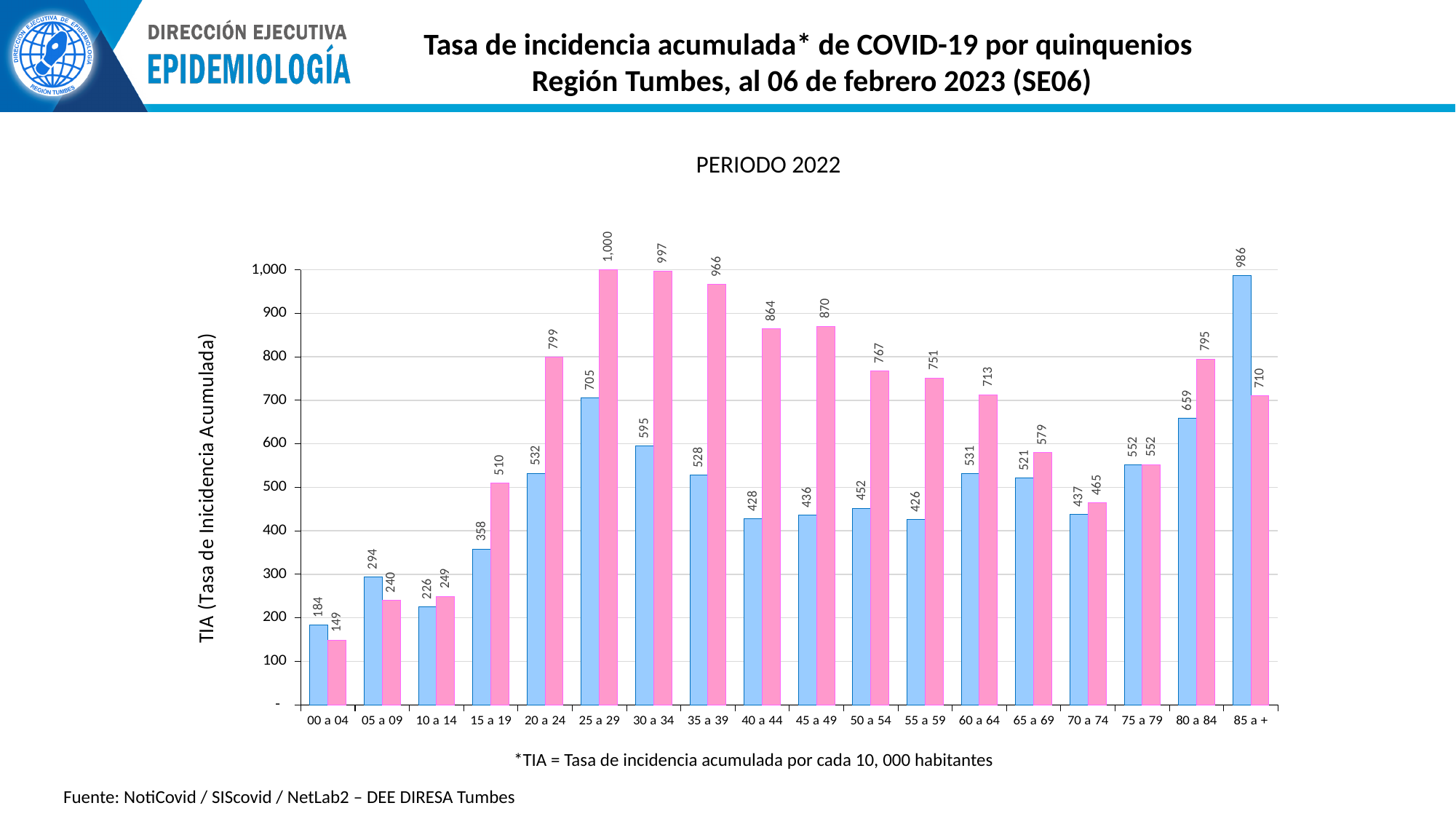
What is the subtitle shown above the chart? PERIODO 2022 What is the value of both bars for the 75 a 79 age group? 552 What type of chart is shown on the slide? bar chart What is the difference between the pink bar and the blue bar for the 20 a 24 age group? 267 Which age group has the lowest blue bar? 00 a 04 What is the value of the pink bar for the 30 a 34 age group? 997 What is the value of the blue bar for the 25 a 29 age group? 705 For the 85 a + age group, which is larger, the blue bar or the pink bar? the blue bar Is the value of the pink bar for the 40 a 44 age group greater or less than 800? greater Which age group has the highest pink bar? 25 a 29 Which age group has the highest blue bar? 85 a + How many age-group categories are shown on the x axis? 18